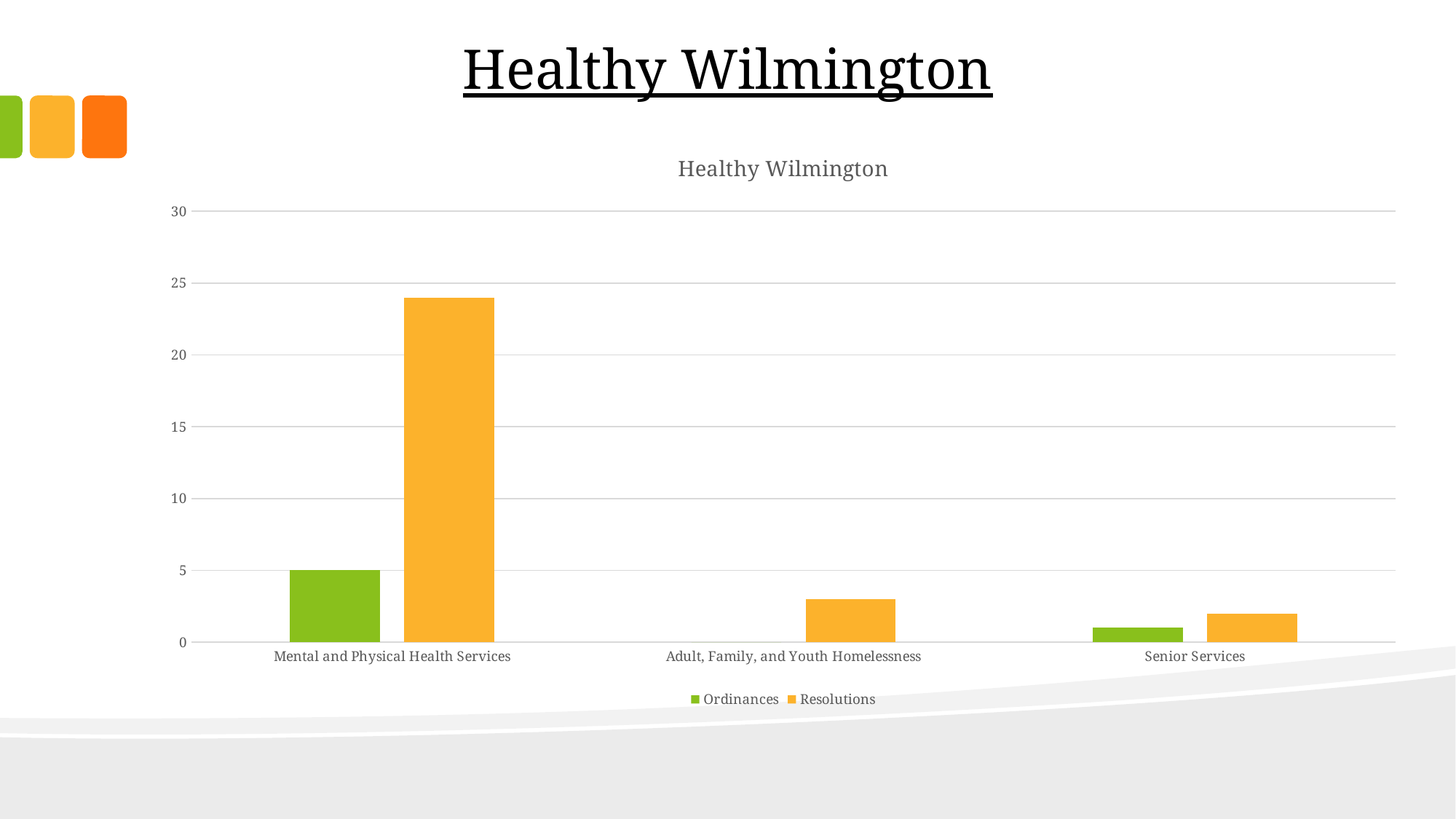
What type of chart is shown on the slide? bar chart Is the Resolutions value for Mental and Physical Health Services greater or less than 25? less How many categories are shown on the x axis of the chart? 3 For Mental and Physical Health Services, which is larger: Ordinances or Resolutions? Resolutions Is the Resolutions value for Adult, Family, and Youth Homelessness greater or less than 5? less Which category has the highest Ordinances value? Mental and Physical Health Services What is the title of the chart? Healthy Wilmington Which category has the highest Resolutions value? Mental and Physical Health Services How many series does the chart's legend list? 2 For Senior Services, which is larger: Ordinances or Resolutions? Resolutions What is the value of Ordinances for Mental and Physical Health Services? 5 Is the Resolutions value for Mental and Physical Health Services greater or less than 20? greater